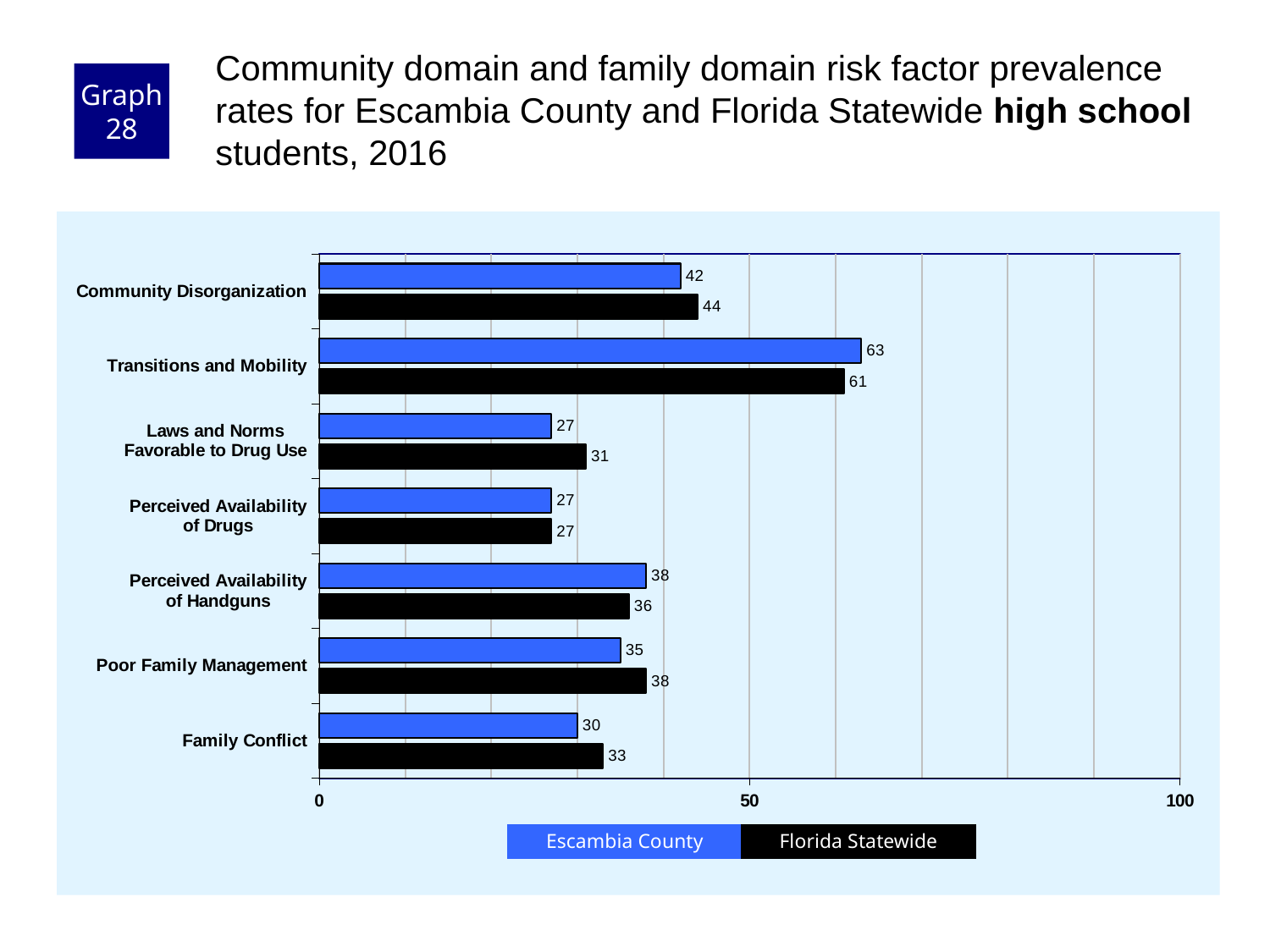
How many series does the legend list? 2 Which risk factor has the highest Escambia County value? Transitions and Mobility For Family Conflict, which is larger: the Escambia County value or the Florida Statewide value? Florida Statewide What is the difference between the Florida Statewide and Escambia County values for Poor Family Management? 3 Which risk factor has the lowest Florida Statewide value? Perceived Availability of Drugs What is the Escambia County value for Transitions and Mobility? 63 What is the Florida Statewide value for Community Disorganization? 44 What is the Florida Statewide value for Laws and Norms Favorable to Drug Use? 31 What kind of chart is shown on the slide? Bar chart Which colour represents Florida Statewide in the chart? Black Is the Escambia County value for Transitions and Mobility greater or less than 50? greater How many risk factor categories are shown on the chart? 7